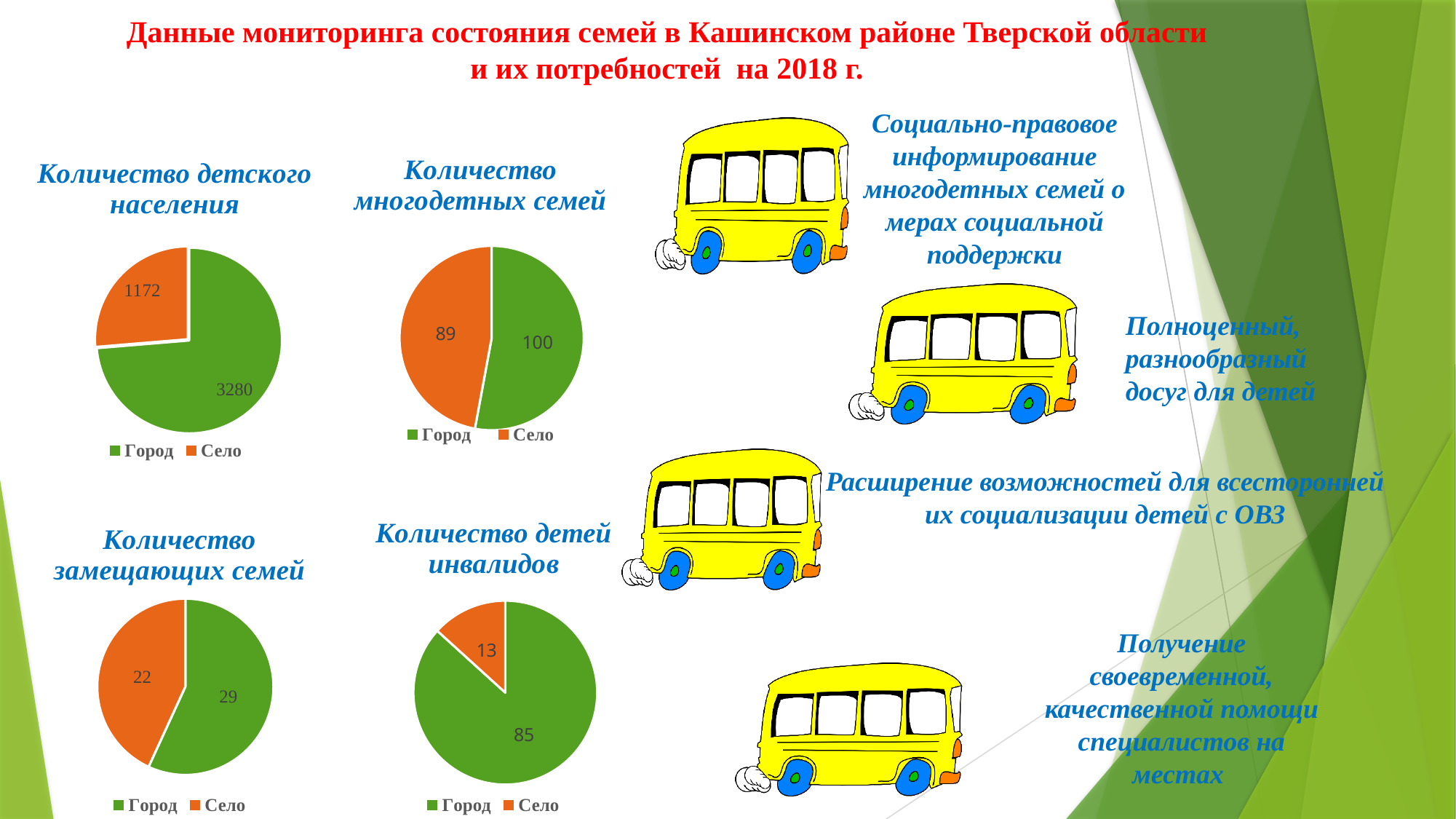
How many pie charts are shown on the slide? 4 How many series does the legend of the chart 'Количество замещающих семей' list? 2 What type of chart is 'Количество детей инвалидов'? Pie chart In the chart 'Количество детей инвалидов', what is the value for Село? 13 In the chart 'Количество детского населения', what is the value for Город? 3280 In the chart 'Количество детей инвалидов', which category has the largest slice? Город In the chart 'Количество детского населения', what is the value for Село? 1172 In the chart 'Количество многодетных семей', which is larger, Город or Село? Город In the chart 'Количество многодетных семей', what is the value for Село? 89 In the chart 'Количество детского населения', what is the difference between Город and Село? 2108 In the chart 'Количество замещающих семей', what is the difference between Город and Село? 7 In the chart 'Количество замещающих семей', what is the value for Город? 29